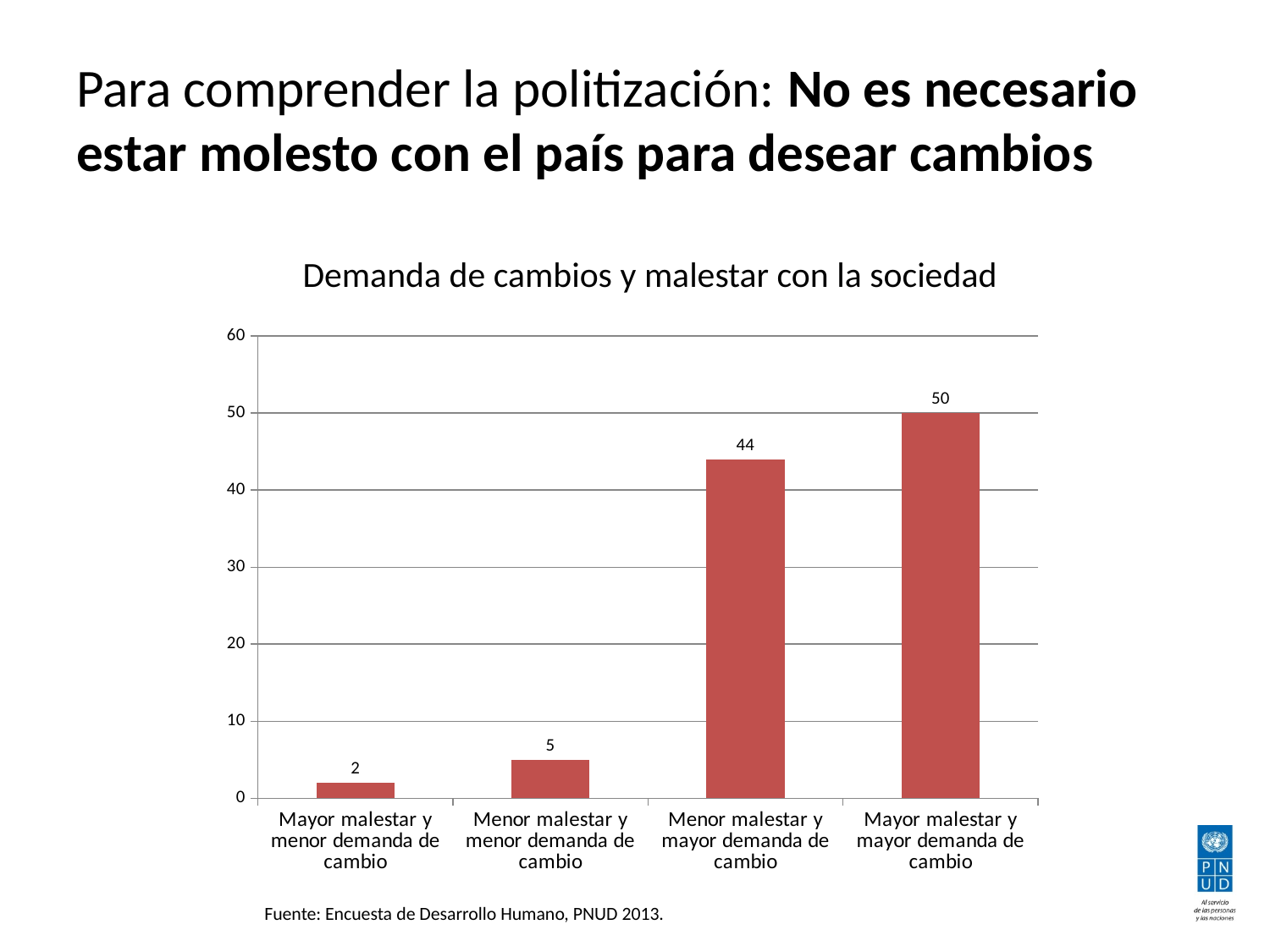
Which is larger: the value for "Menor malestar y menor demanda de cambio" or "Mayor malestar y menor demanda de cambio"? Menor malestar y menor demanda de cambio How many categories are shown in the chart? 4 What kind of chart is shown on the slide? Bar chart Which category has the lowest value? Mayor malestar y menor demanda de cambio What is the value for "Mayor malestar y menor demanda de cambio"? 2 What is the value for "Mayor malestar y mayor demanda de cambio"? 50 What is the title of the chart? Demanda de cambios y malestar con la sociedad What is the value for "Menor malestar y menor demanda de cambio"? 5 Which category has the highest value? Mayor malestar y mayor demanda de cambio What is the difference between the values for "Mayor malestar y mayor demanda de cambio" and "Menor malestar y mayor demanda de cambio"? 6 What is the value for "Menor malestar y mayor demanda de cambio"? 44 Is the value for "Menor malestar y mayor demanda de cambio" greater or less than 40? greater